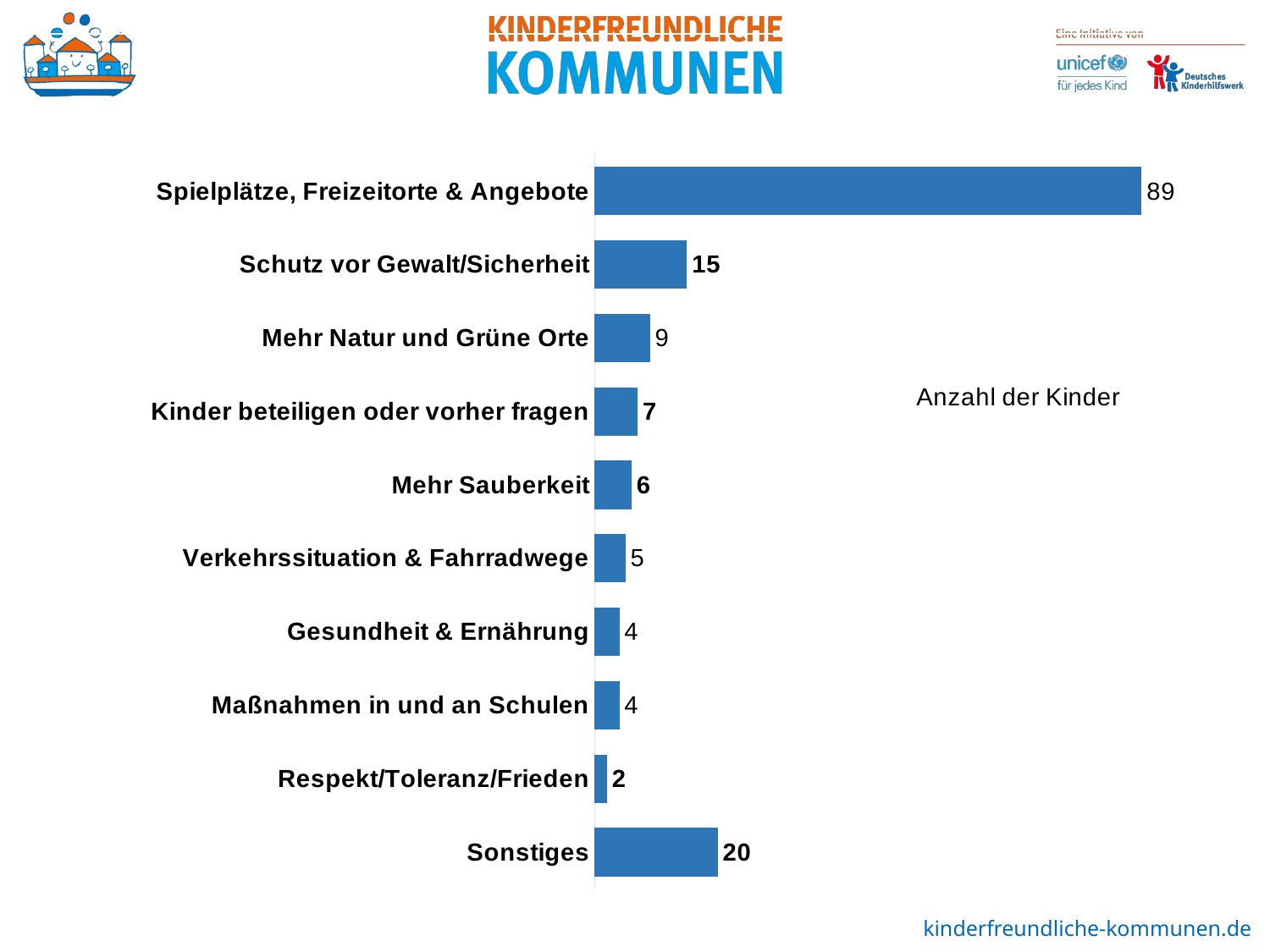
What is the value for Sonstiges? 20 What label is shown to the right of the bars describing the plotted quantity? Anzahl der Kinder How many categories are shown in the chart? 10 What is the value for Schutz vor Gewalt/Sicherheit? 15 What is the value for Spielplätze, Freizeitorte & Angebote? 89 Which category has the lowest value? Respekt/Toleranz/Frieden What is the difference between the values for Schutz vor Gewalt/Sicherheit and Mehr Natur und Grüne Orte? 6 What is the value for Mehr Natur und Grüne Orte? 9 What kind of chart is shown on the slide? bar chart Which category has the highest value? Spielplätze, Freizeitorte & Angebote What is the difference between the values for Spielplätze, Freizeitorte & Angebote and Sonstiges? 69 Which is larger, the value for Kinder beteiligen oder vorher fragen or the value for Verkehrssituation & Fahrradwege? Kinder beteiligen oder vorher fragen